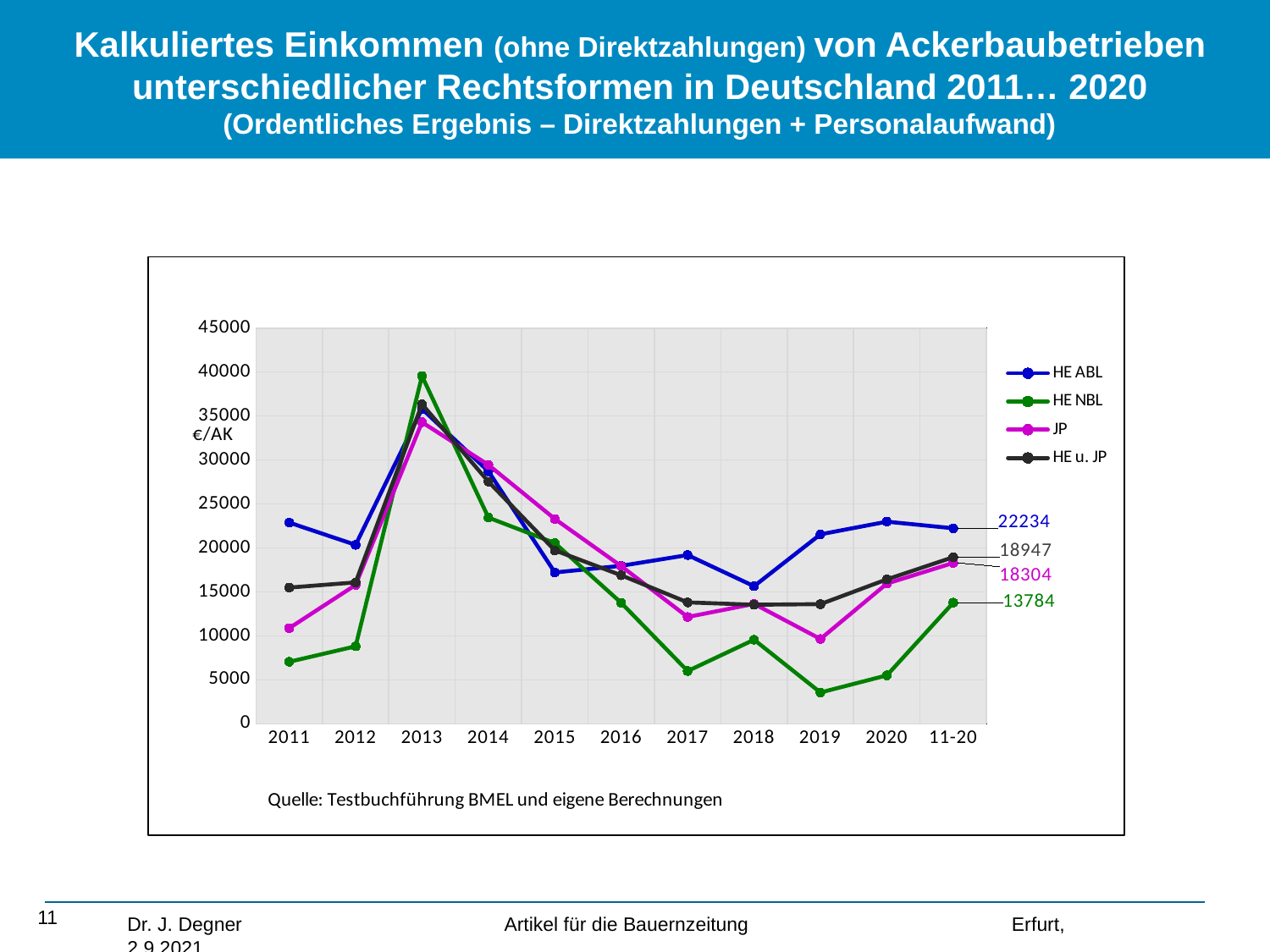
What is the value for JP at 11-20? 18304 What is the value for HE NBL at 11-20? 13784 How many series does the legend list? 4 What unit is shown on the y axis of the chart? €/AK In which year does the HE NBL series reach its lowest value? 2019 What is the value for HE ABL at 11-20? 22234 Is the value for HE NBL in 2017 greater or less than 10000? less Which series has the highest value at 11-20? HE ABL What is the difference between the HE ABL and HE NBL values at 11-20? 8450 What kind of chart is shown on the slide? line chart What is the value for HE u. JP at 11-20? 18947 Is the value for HE NBL in 2013 greater or less than 35000? greater